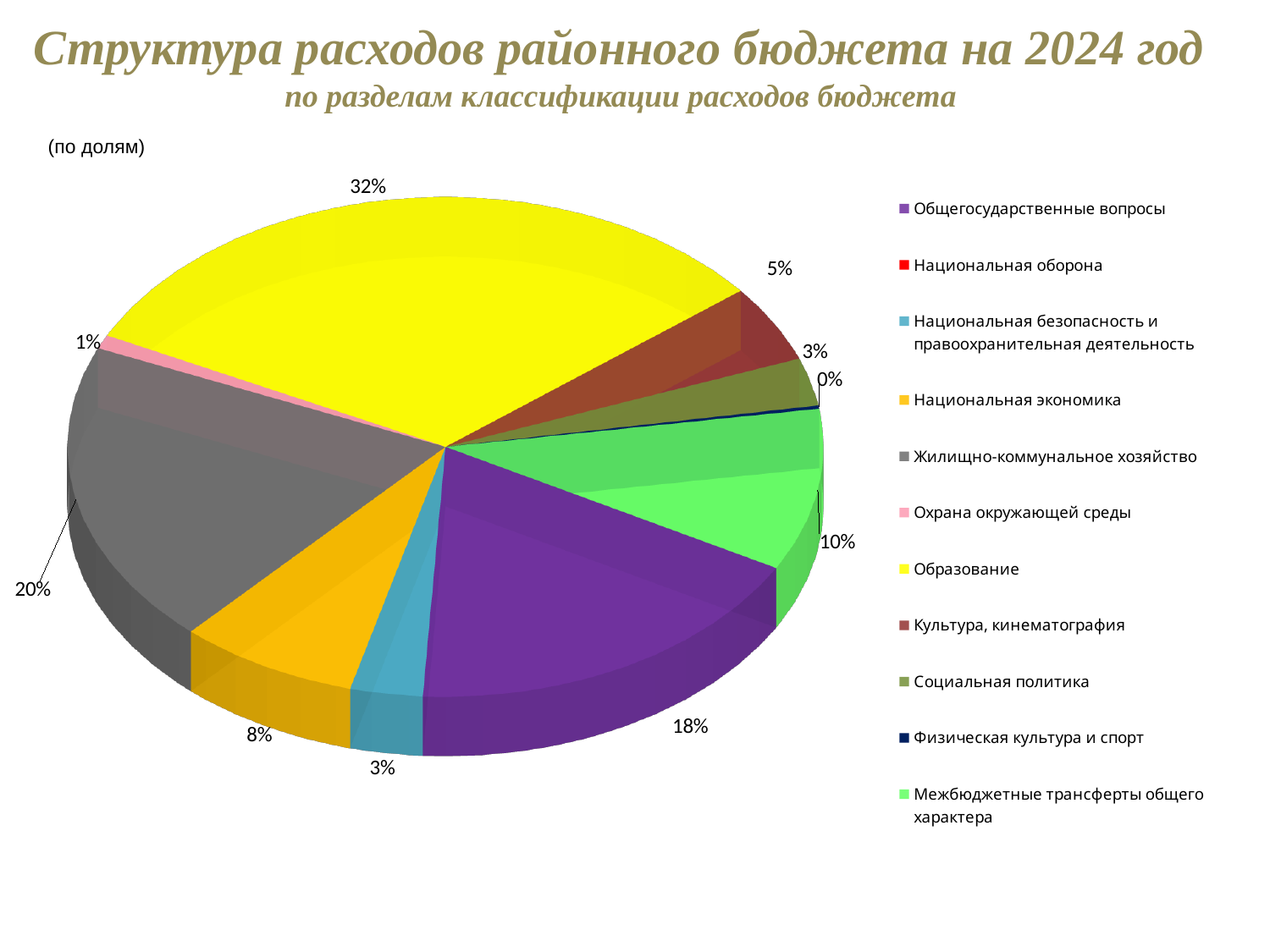
How many categories does the legend list? 11 What colour is the slice for Образование? Yellow What share of the pie does Национальная экономика have? 8% What share of the pie does Образование have? 32% What share of the pie does Жилищно-коммунальное хозяйство have? 20% Which is larger: the share for Жилищно-коммунальное хозяйство or the share for Общегосударственные вопросы? Жилищно-коммунальное хозяйство What kind of chart is shown on the slide? Pie chart What share of the pie does Межбюджетные трансферты общего характера have? 10% What share of the pie does Культура, кинематография have? 5% Which category has the largest share of the pie? Образование What share of the pie does Общегосударственные вопросы have? 18% What is the difference between the share for Образование and the share for Жилищно-коммунальное хозяйство? 12%